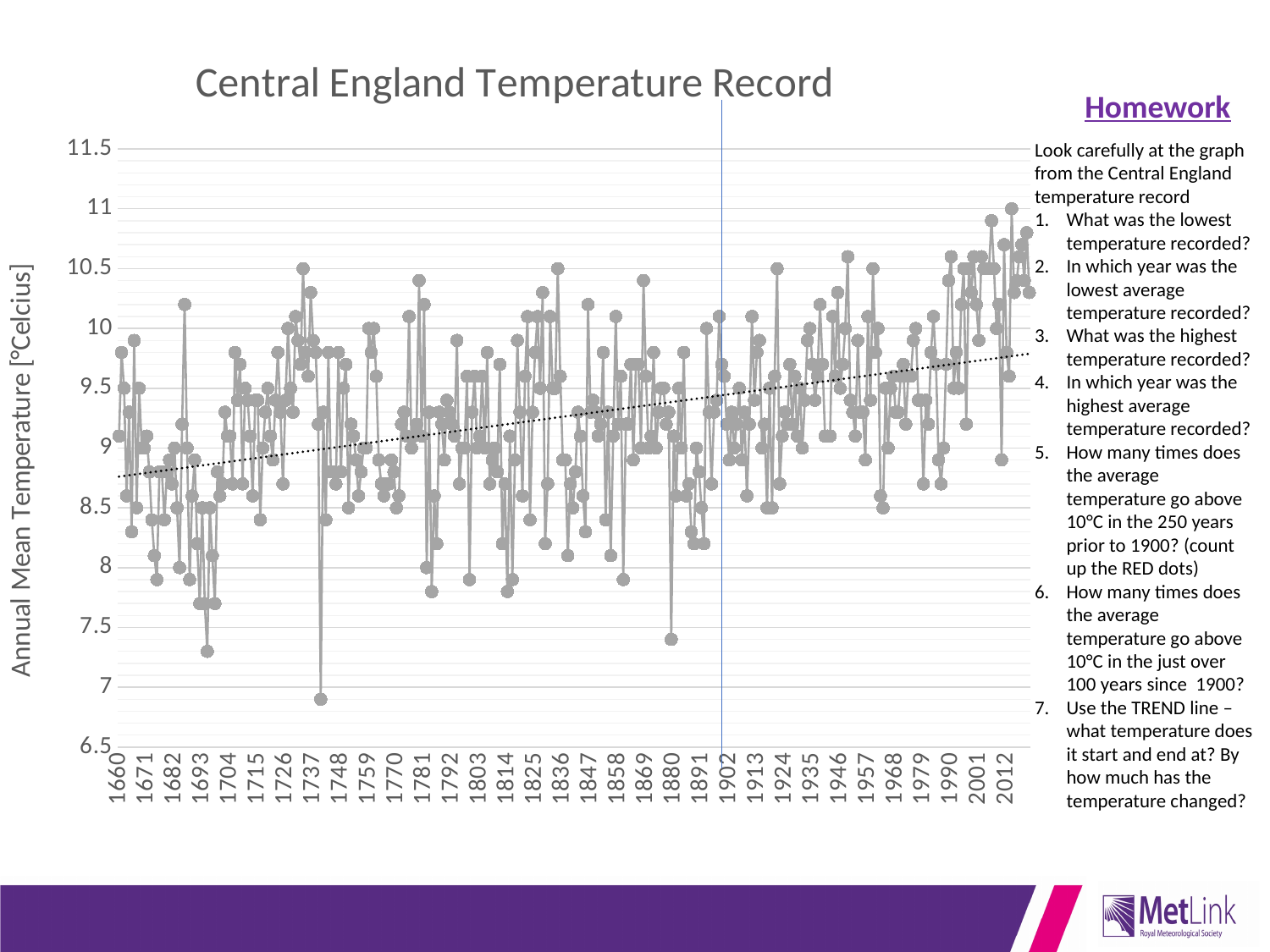
What kind of chart is shown on the slide? Line chart What is the highest value shown on the vertical axis? 11.5 Is the highest plotted annual mean temperature on the chart greater or less than 10.5? greater What is the label on the vertical axis of the chart? Annual Mean Temperature [°Celcius] What is the last year label shown on the x axis? 2012 Is the lowest plotted annual mean temperature on the chart greater or less than 7.5? less At which year label is the vertical blue line drawn on the chart? 1902 Is the value of the dotted trend line at its end (around 2012) greater or less than 9.5? greater What is the title of the chart? Central England Temperature Record What is the first year label shown on the x axis? 1660 According to the dotted trend line, do the annual mean temperatures rise or fall from 1660 to 2012? Rise